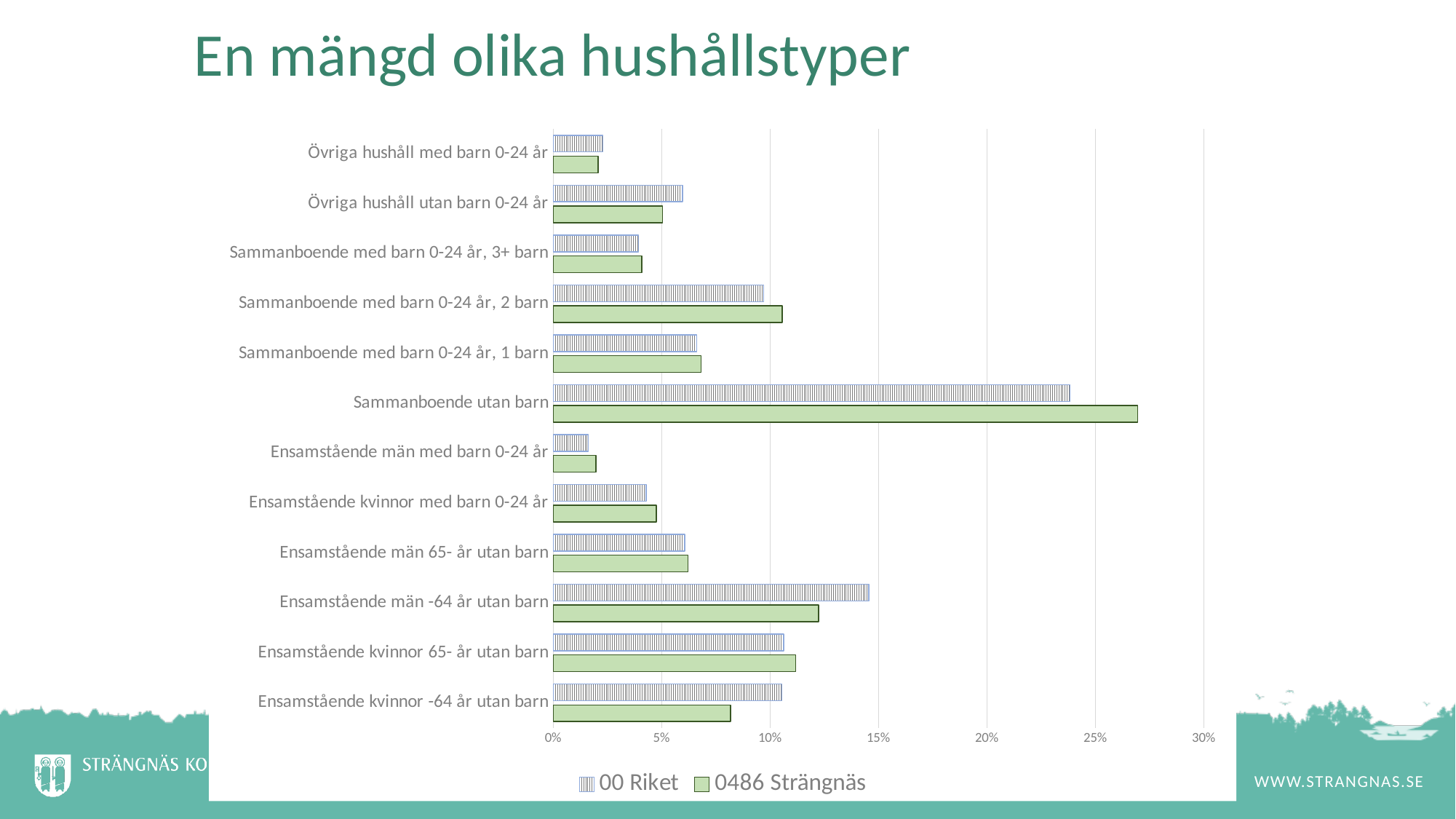
Is the 0486 Strängnäs value for Sammanboende utan barn greater or less than 25%? greater Which household category has the highest value for 00 Riket? Sammanboende utan barn Which household category has the highest value for 0486 Strängnäs? Sammanboende utan barn How many series does the legend list? 2 Which household category has the lowest value for 00 Riket? Ensamstående män med barn 0-24 år How many household categories are plotted on the chart? 12 What kind of chart is shown on the slide? bar chart For Ensamstående kvinnor -64 år utan barn, which series has the larger value, 00 Riket or 0486 Strängnäs? 00 Riket For Sammanboende utan barn, which series has the larger value, 00 Riket or 0486 Strängnäs? 0486 Strängnäs For Ensamstående män -64 år utan barn, which series has the larger value, 00 Riket or 0486 Strängnäs? 00 Riket Is the 00 Riket value for Ensamstående män -64 år utan barn greater or less than 15%? less What are the two series names shown in the legend? 00 Riket and 0486 Strängnäs